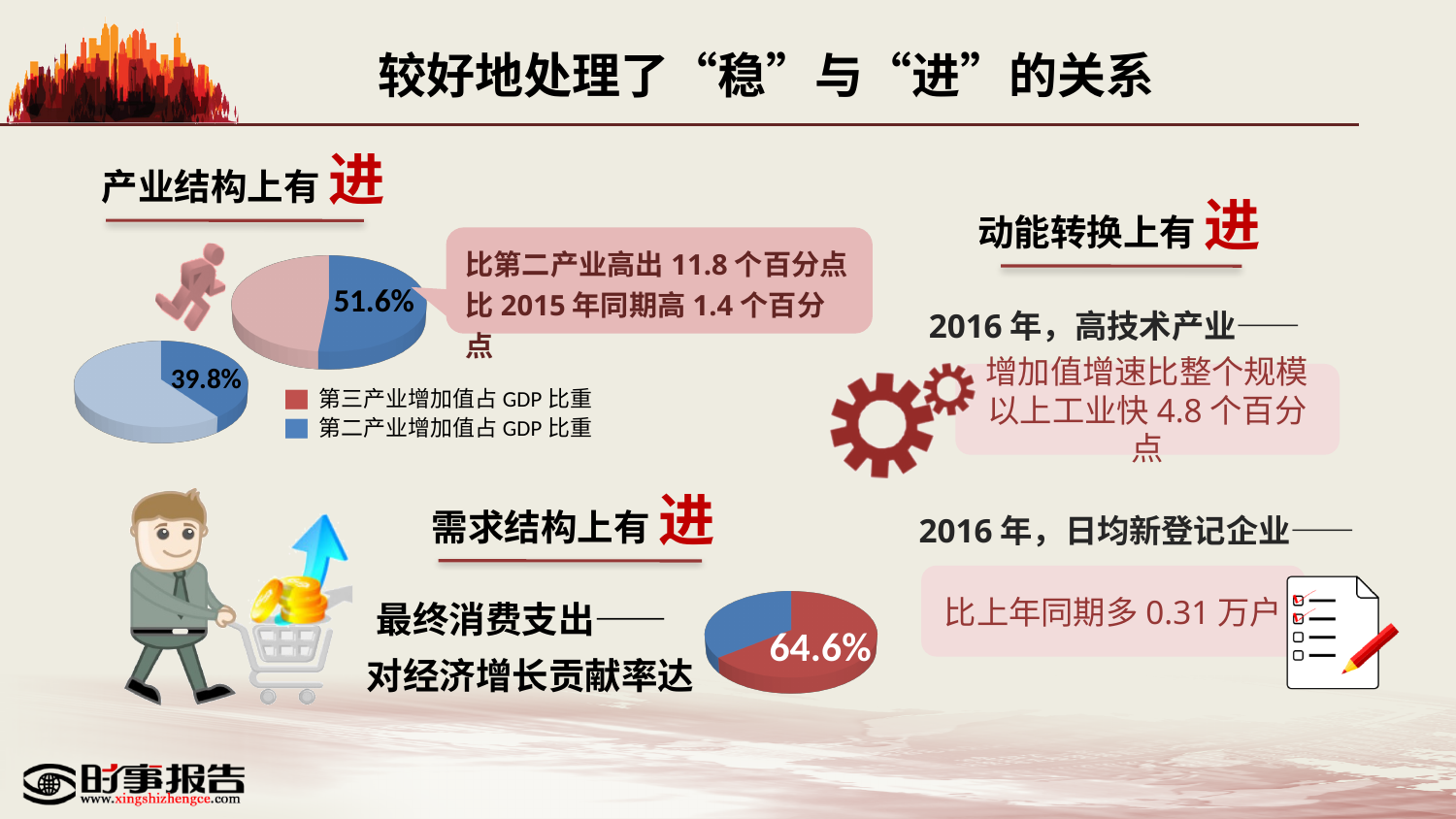
In the legend of the top-left section, which entry is shown with the red colour? 第三产业增加值占 GDP 比重 Among the three pie charts on the slide, which printed data label is the highest? 64.6% Is the 64.6% value on the bottom pie chart greater or less than 50%? greater What is the difference between the 51.6% label on the upper pie chart and the 39.8% label on the lower pie chart in the top-left section? 11.8 percentage points On the lower pie chart in the top-left section (产业结构上有进), what percentage is printed as the data label? 39.8% How many entries does the legend in the top-left section (产业结构上有进) list? 2 How many pie charts are shown on the slide in total? 3 In the legend of the top-left section, which entry is shown with the blue colour? 第二产业增加值占 GDP 比重 On the upper pie chart in the top-left section (产业结构上有进), what percentage is printed as the data label? 51.6% In the top-left section, which labelled value is larger: the 51.6% on the upper pie chart or the 39.8% on the lower pie chart? 51.6% On the pie chart in the bottom section (需求结构上有进), what percentage is printed as the data label? 64.6% What kind of chart is used in the bottom section (需求结构上有进) to show 64.6%? Pie chart